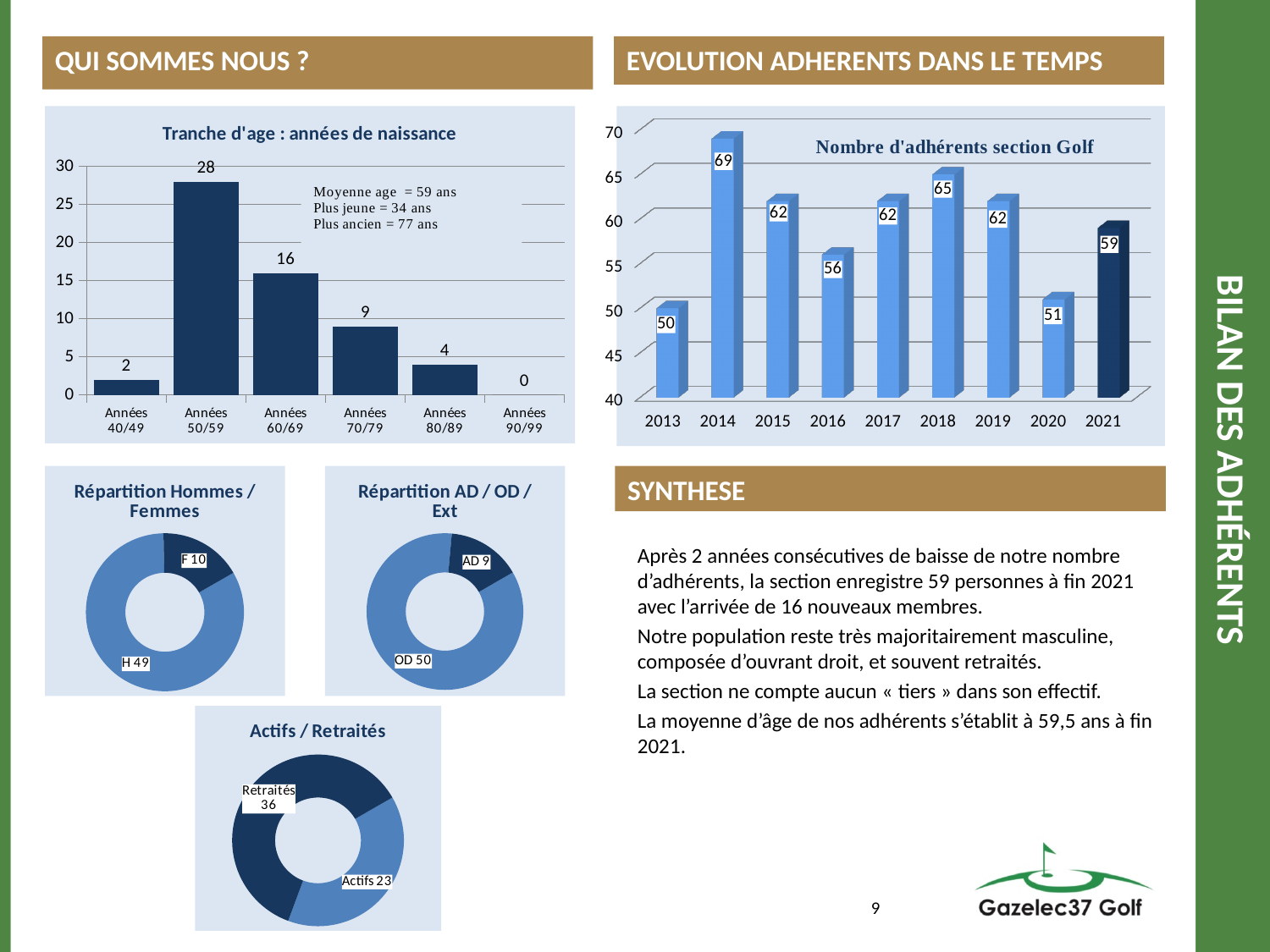
In the 'Nombre d'adhérents section Golf' chart, what is the value for 2014? 69 In the 'Nombre d'adhérents section Golf' chart, what is the difference between 2018 and 2020? 14 In the 'Tranche d'age : années de naissance' chart, which age bracket has the highest value? Années 50/59 How many age brackets are shown in the 'Tranche d'age : années de naissance' chart? 6 In the 'Tranche d'age : années de naissance' chart, what is the difference between Années 60/69 and Années 70/79? 7 What kind of chart is 'Nombre d'adhérents section Golf'? Bar chart In the 'Nombre d'adhérents section Golf' chart, which is larger, the value for 2016 or the value for 2021? 2021 In the 'Actifs / Retraités' chart, what is the total of Actifs and Retraités? 59 In the 'Nombre d'adhérents section Golf' chart, which year has the lowest value? 2013 In the 'Répartition Hommes / Femmes' chart, what is the value for H? 49 In the 'Répartition AD / OD / Ext' chart, which is larger, AD or OD? OD In the 'Tranche d'age : années de naissance' chart, what is the value for Années 50/59? 28